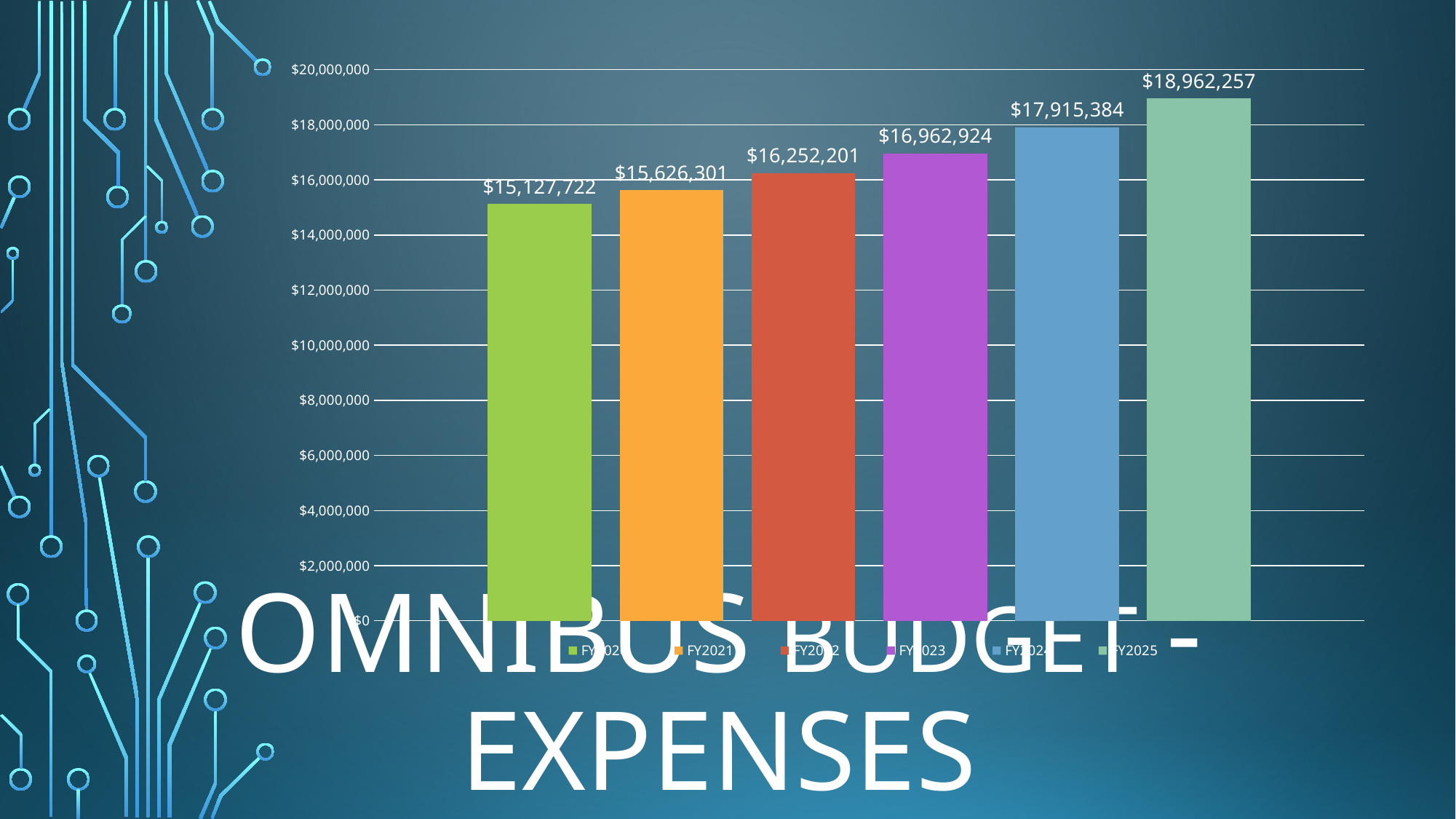
What is the value for FY2025? $18,962,257 How many bars are shown in the chart? 6 Do the values rise or fall from left to right across the fiscal years? rise Which is larger, the value for FY2022 or the value for FY2024? FY2024 What is the value for FY2024? $17,915,384 What kind of chart is shown on the slide? bar chart What is the value for FY2021? $15,626,301 What is the value for FY2023? $16,962,924 Is the value for FY2023 greater or less than $18,000,000? less What is the difference between the FY2023 and FY2021 values? $1,336,623 What is the difference between the FY2025 and FY2024 values? $1,046,873 Which fiscal year has the highest expenses? FY2025